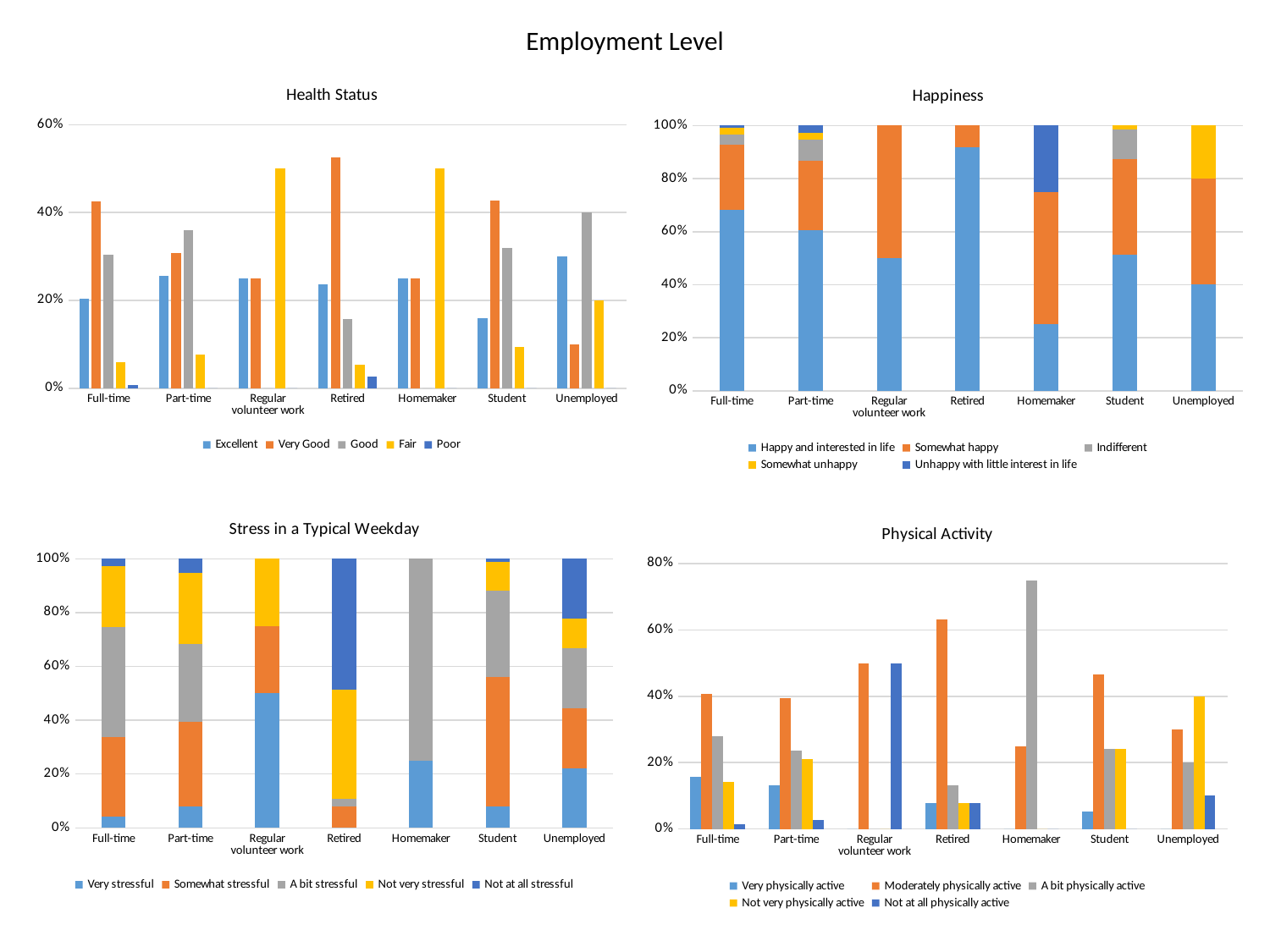
In the Happiness chart, which employment category has the largest 'Happy and interested in life' share? Retired In the Physical Activity chart, which is larger: the 'Very physically active' value for Full-time or for Student? Full-time In the Health Status chart, which employment category has the highest Very Good value? Retired How many series does the legend of the Happiness chart list? 5 In the Physical Activity chart, which employment category has the highest 'A bit physically active' value? Homemaker How many employment categories are shown on the x axis of the Health Status chart? 7 In the Happiness chart, is the 'Happy and interested in life' share for Retired greater or less than 80%? greater What kind of chart is the Health Status chart? bar chart How many series does the legend of the Health Status chart list? 5 In the Health Status chart, is the Very Good value for Retired greater or less than 40%? greater In the Stress in a Typical Weekday chart, is the 'Not at all stressful' share for Retired greater or less than 40%? greater